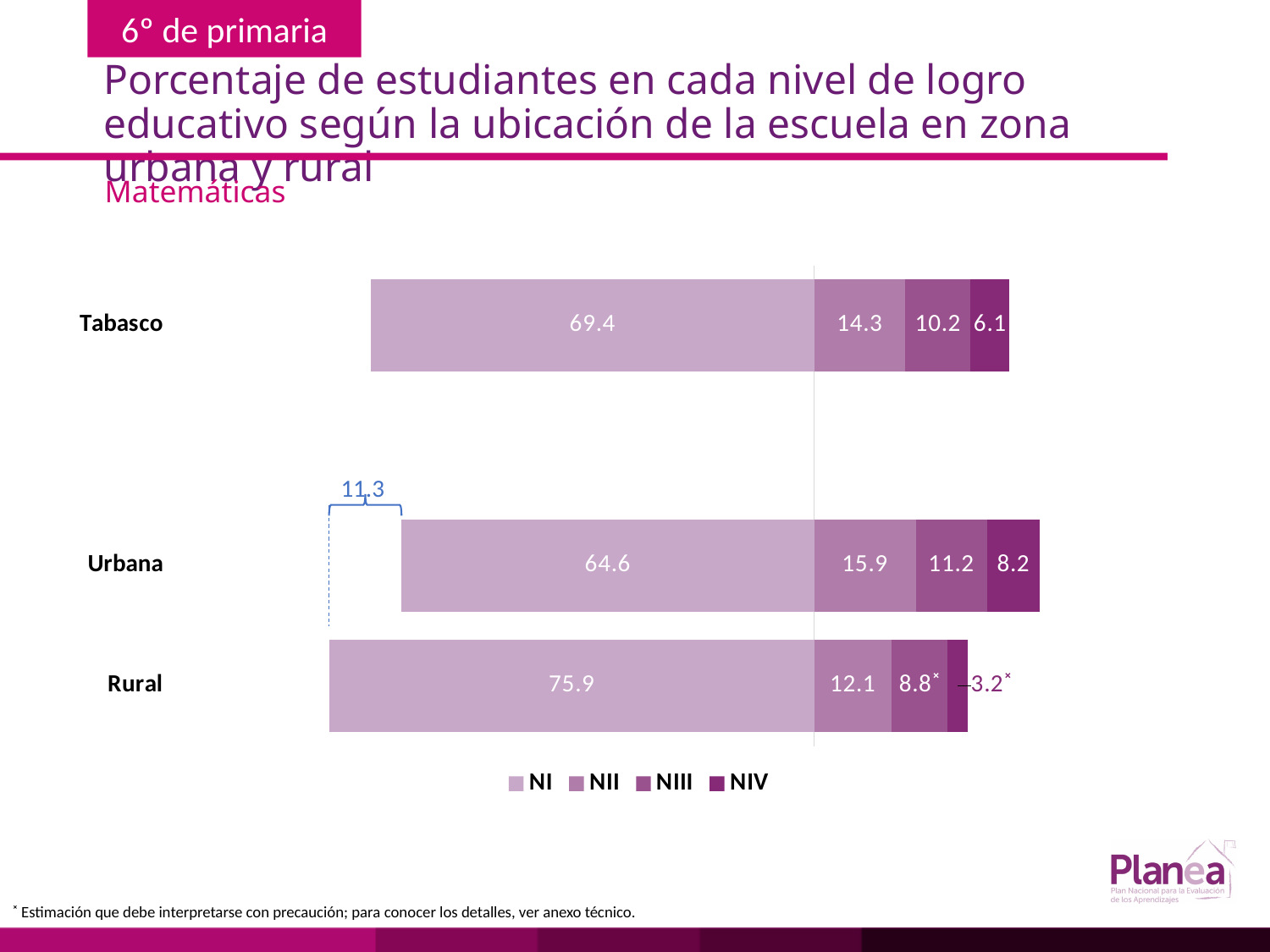
Which category has the highest NI value? Rural What is the difference between the NI values for Rural and Urbana? 11.3 What is the NIV value for Urbana? 8.2 Which is larger, the NII value for Urbana or for Tabasco? Urbana How many categories are shown on the chart? 3 What is the NIII value for Rural? 8.8 Which category has the lowest NIV value? Rural What percentage of Rural students are at level NI? 75.9 What kind of chart is shown on the slide? Stacked bar chart What is the total of the stacked bar for Tabasco? 100 What is the NII value for Tabasco? 14.3 How many series does the legend list? 4